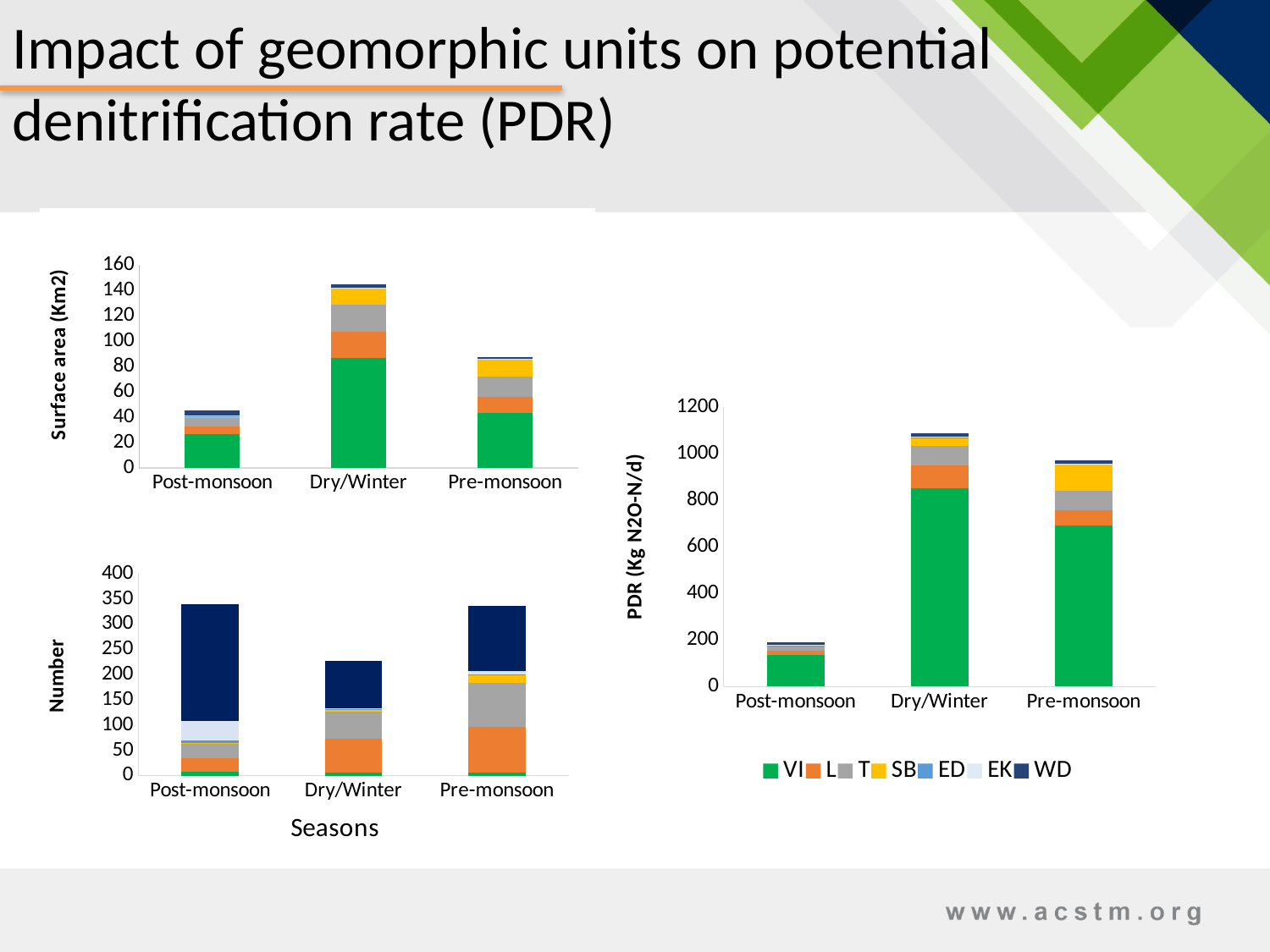
In the Number chart, which season has the shortest stacked bar? Dry/Winter In the Number chart, is the total for Dry/Winter greater or less than 250? less In the PDR (Kg N2O-N/d) chart, which season has the highest total PDR? Dry/Winter How many seasons are shown on the x axis of the Surface area (Km2) chart? 3 How many series does the legend on the slide list? 7 What is the x-axis title of the Number chart? Seasons What kind of chart is the PDR (Kg N2O-N/d) chart on the right of the slide? Stacked bar chart In the Surface area (Km2) chart, which season has the shortest stacked bar? Post-monsoon In the Surface area (Km2) chart, which season has the tallest stacked bar? Dry/Winter In the PDR (Kg N2O-N/d) chart, which has the larger total, Pre-monsoon or Post-monsoon? Pre-monsoon In the Surface area (Km2) chart, is the total for Dry/Winter greater or less than 120? greater